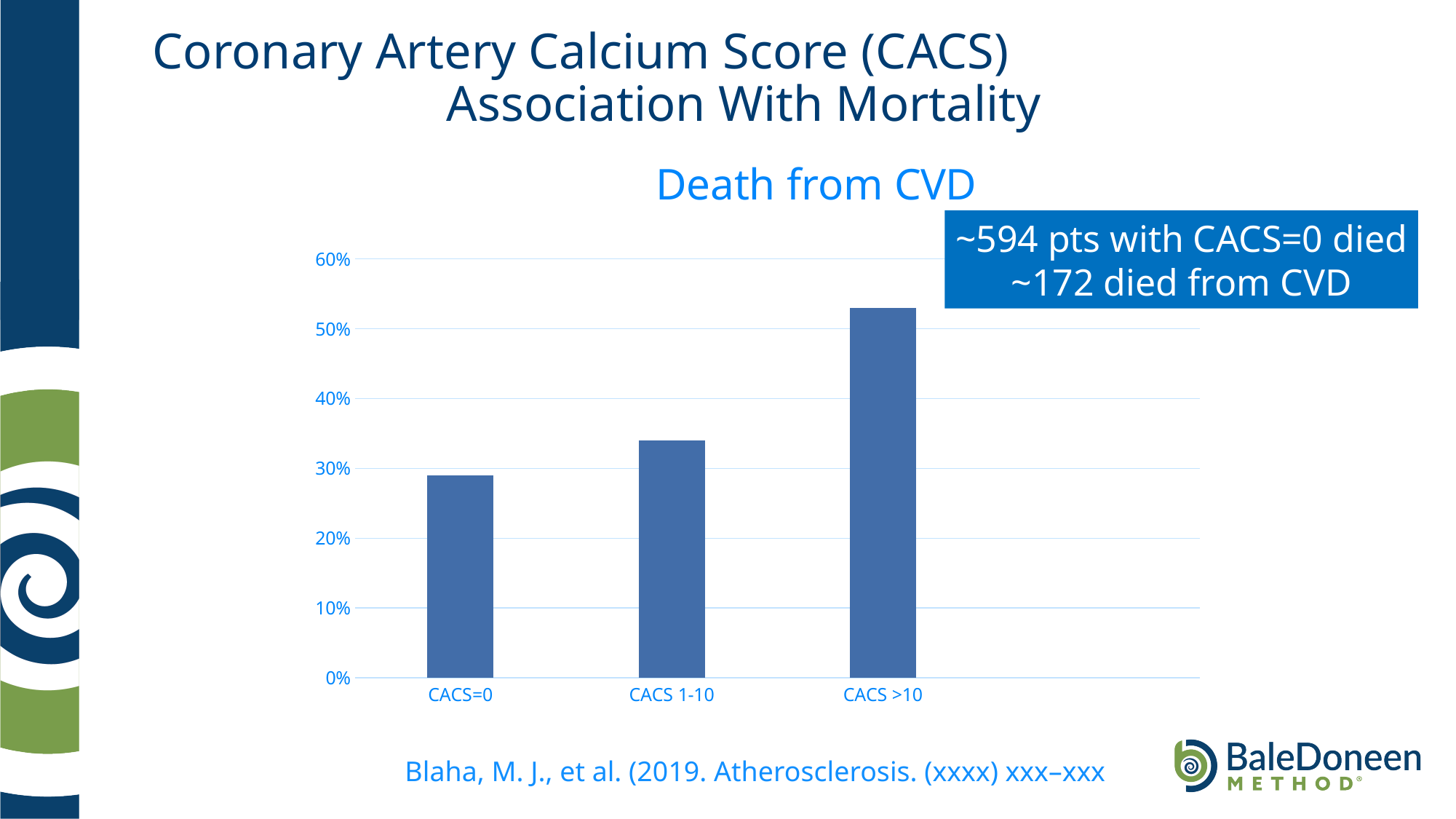
Which is larger, the value for CACS 1-10 or the value for CACS >10? CACS >10 What kind of chart is shown on the slide? bar chart How many categories are plotted on the x axis of the chart? 3 Which category has the highest value in the chart? CACS >10 Do the values rise or fall moving from CACS=0 to CACS >10 along the x axis? rise What is the highest value labelled on the chart's vertical axis? 60% What is the title of the chart? Death from CVD Is the value for CACS >10 greater or less than 50%? greater Which is larger, the value for CACS=0 or the value for CACS 1-10? CACS 1-10 Which category has the lowest value in the chart? CACS=0 Is the value for CACS 1-10 greater or less than 30%? greater